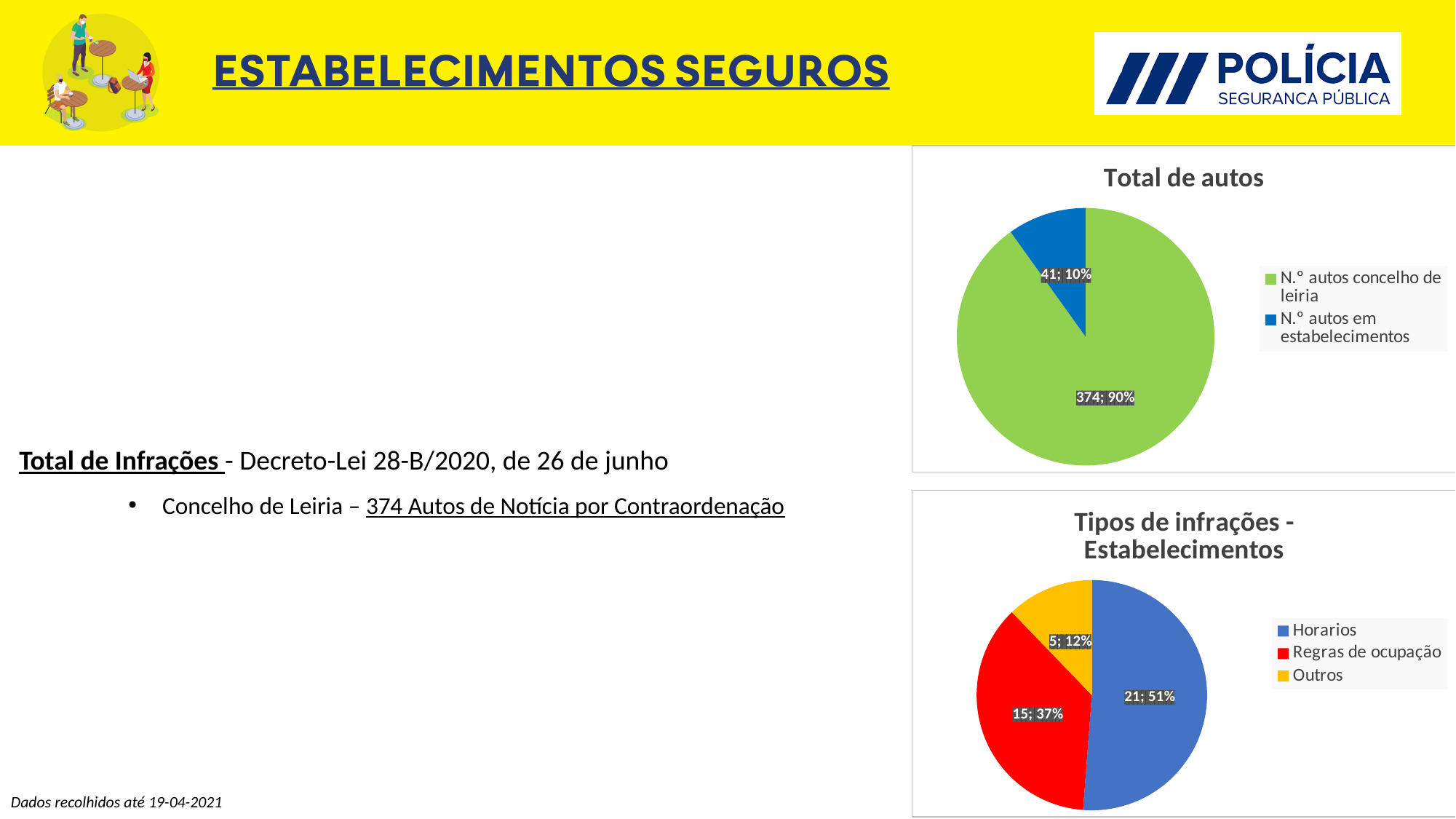
In the 'Total de autos' chart, what value is shown for 'N.º autos em estabelecimentos'? 41 In the 'Total de autos' chart, how many categories does the legend list? 2 In the 'Tipos de infrações - Estabelecimentos' chart, which is larger: 'Regras de ocupação' or 'Outros'? Regras de ocupação In the 'Tipos de infrações - Estabelecimentos' chart, how many categories are plotted? 3 In the 'Tipos de infrações - Estabelecimentos' chart, which category has the smallest slice? Outros In the 'Total de autos' chart, what percentage share does 'N.º autos concelho de leiria' have? 90% What kind of chart is 'Total de autos'? Pie chart In the 'Tipos de infrações - Estabelecimentos' chart, what is the difference between the values for 'Horarios' and 'Regras de ocupação'? 6 In the 'Tipos de infrações - Estabelecimentos' chart, what value is shown for 'Regras de ocupação'? 15 In the 'Total de autos' chart, which category has the largest slice? N.º autos concelho de leiria In the 'Tipos de infrações - Estabelecimentos' chart, what percentage share does 'Horarios' have? 51% In the 'Tipos de infrações - Estabelecimentos' chart, what colour is the 'Outros' slice? Yellow